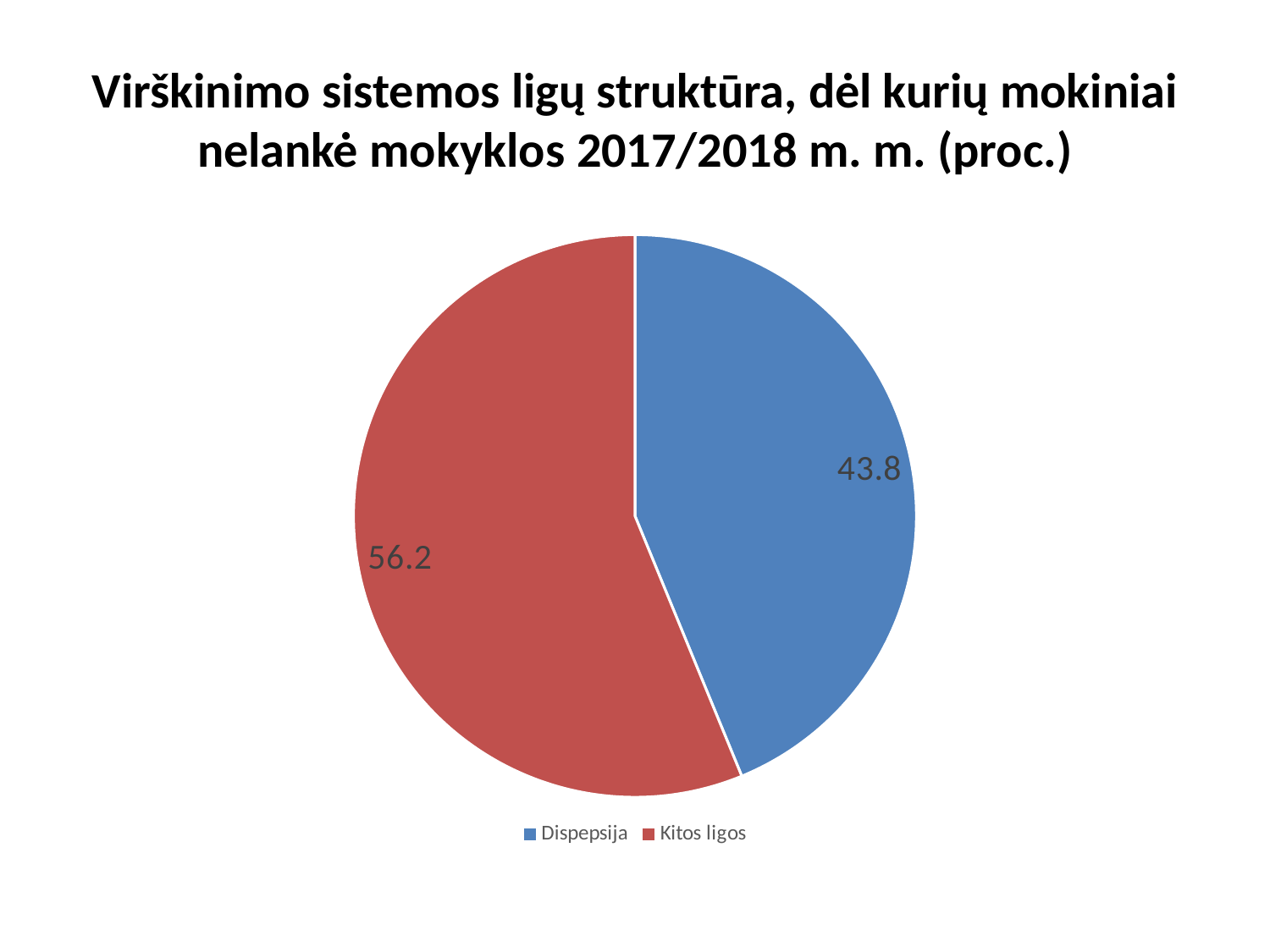
What share of the pie does Dispepsija represent? 43.8 What is the difference between the values for Kitos ligos and Dispepsija? 12.4 What colour is the slice for Kitos ligos? Red What is the total of the two values shown on the pie chart? 100 What value is shown for Kitos ligos? 56.2 Which category has the smallest slice of the pie? Dispepsija How many categories does the pie chart show? 2 Which category has the largest slice of the pie? Kitos ligos Which is larger, the value for Dispepsija or the value for Kitos ligos? Kitos ligos What kind of chart is shown on the slide? Pie chart What value is shown for Dispepsija? 43.8 How many entries does the legend list? 2